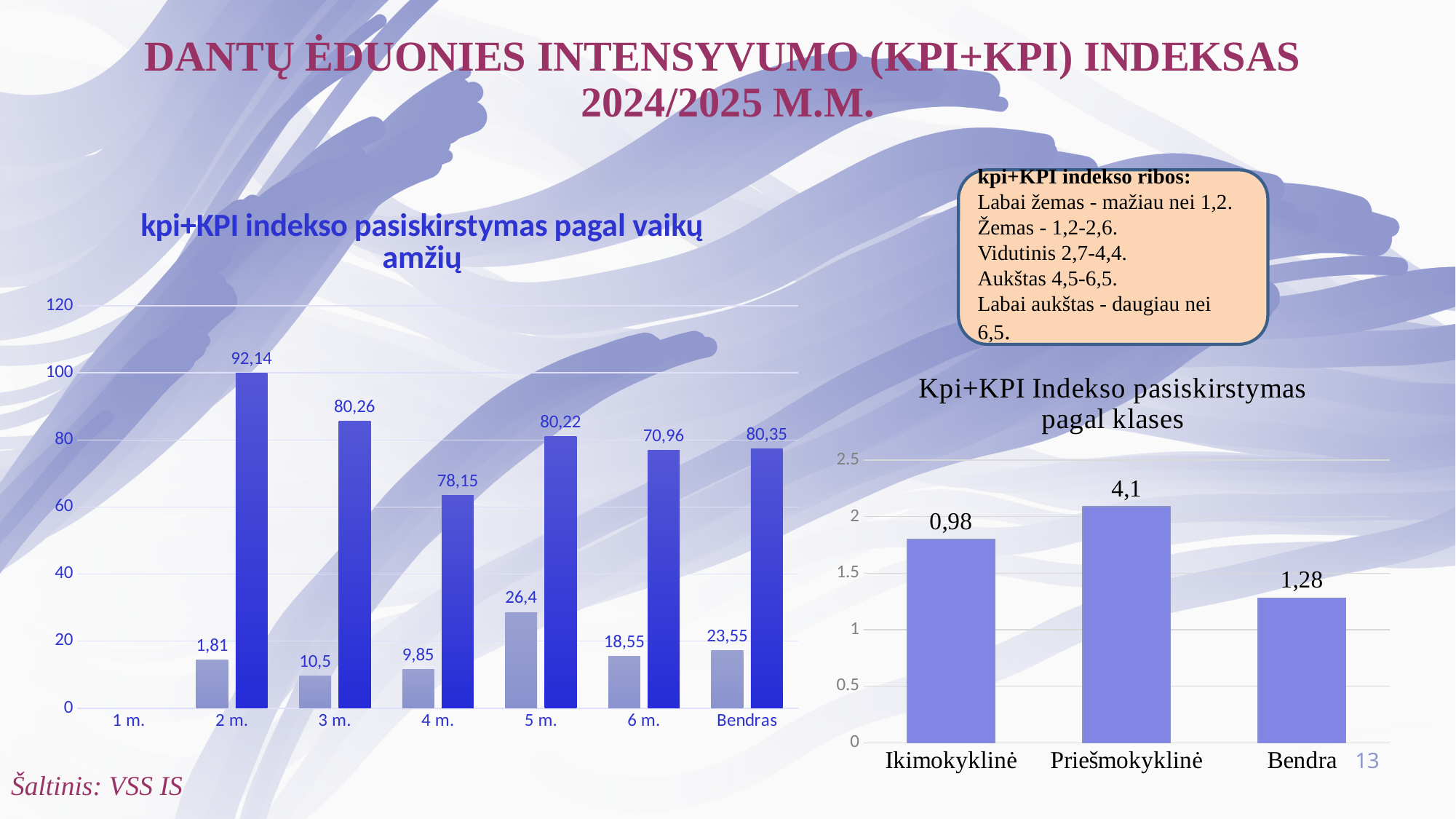
How many age categories are shown on the x axis of the chart 'kpi+KPI indekso pasiskirstymas pagal vaikų amžių'? 7 In the chart 'Kpi+KPI Indekso pasiskirstymas pagal klases', what is the difference between the labelled values for Bendra (1,28) and Ikimokyklinė (0,98)? 0,3 In the chart 'kpi+KPI indekso pasiskirstymas pagal vaikų amžių', which age category has the lowest blue bar? 4 m. In the chart 'kpi+KPI indekso pasiskirstymas pagal vaikų amžių', what is the difference between the blue bar values for 2 m. (92,14) and 6 m. (70,96)? 21,18 In the chart 'kpi+KPI indekso pasiskirstymas pagal vaikų amžių', is the grey bar value for 6 m. larger or smaller than the grey bar value for 5 m.? smaller What kind of chart is 'Kpi+KPI Indekso pasiskirstymas pagal klases'? bar chart In the chart 'Kpi+KPI Indekso pasiskirstymas pagal klases', which category has the lowest labelled value? Ikimokyklinė In the chart 'kpi+KPI indekso pasiskirstymas pagal vaikų amžių', which age category has the highest blue bar? 2 m. In the chart 'Kpi+KPI Indekso pasiskirstymas pagal klases', what value is labelled for Priešmokyklinė? 4,1 In the chart 'kpi+KPI indekso pasiskirstymas pagal vaikų amžių', what value is labelled on the blue bar for Bendras? 80,35 In the chart 'kpi+KPI indekso pasiskirstymas pagal vaikų amžių', what value is labelled on the tall blue bar for 2 m.? 92,14 In the chart 'kpi+KPI indekso pasiskirstymas pagal vaikų amžių', what value is labelled on the grey bar for 5 m.? 26,4